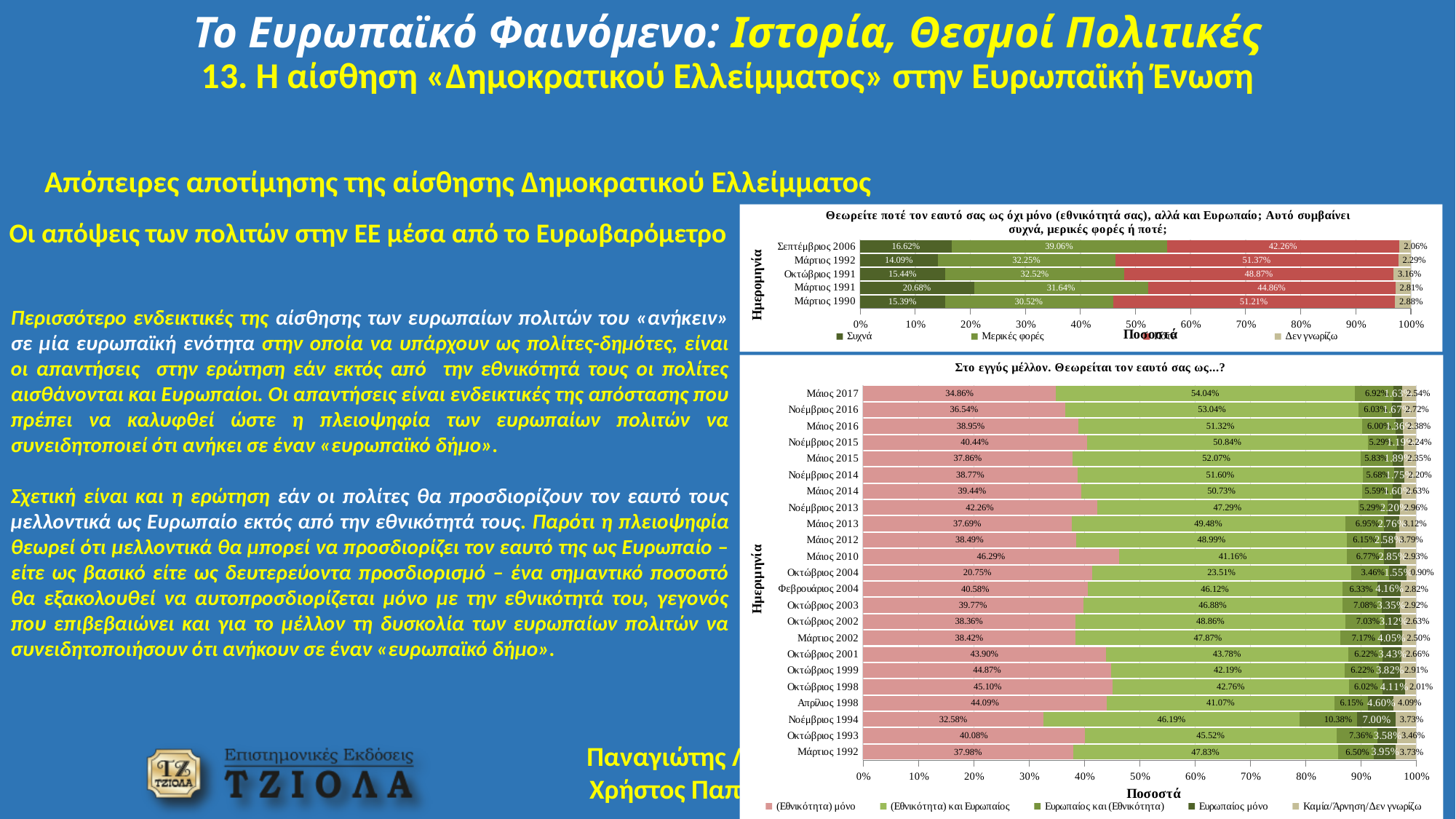
In the bottom chart, which date has the lowest "(Εθνικότητα) μόνο" value? Οκτώβριος 2004 In the top chart, what is the difference between the "Μερικές φορές" values for Σεπτέμβριος 2006 and Μάρτιος 1992? 6.81% In the bottom chart, what is the value of "(Εθνικότητα) και Ευρωπαίος" for Νοέμβριος 1994? 46.19% In the top chart ("Θεωρείτε ποτέ τον εαυτό σας ως όχι μόνο (εθνικότητά σας), αλλά και Ευρωπαίο;"), what is the value of the "Συχνά" segment for Σεπτέμβριος 2006? 16.62% In the top chart, which is larger: the red segment for Μάρτιος 1992 or the red segment for Σεπτέμβριος 2006? Μάρτιος 1992 In the top chart, which date has the highest "Συχνά" value? Μάρτιος 1991 In the top chart, how many dates (categories) are shown? 5 In the bottom chart ("Στο εγγύς μέλλον. Θεωρείται τον εαυτό σας ως...?"), what is the value of "(Εθνικότητα) μόνο" for Μάιος 2017? 34.86% In the top chart, what is the value of the "Μερικές φορές" segment for Μάρτιος 1990? 30.52% In the bottom chart, how many dates (categories) are shown? 23 What type of chart is the bottom chart? Stacked horizontal bar chart In the bottom chart, how many series does the legend list? 5